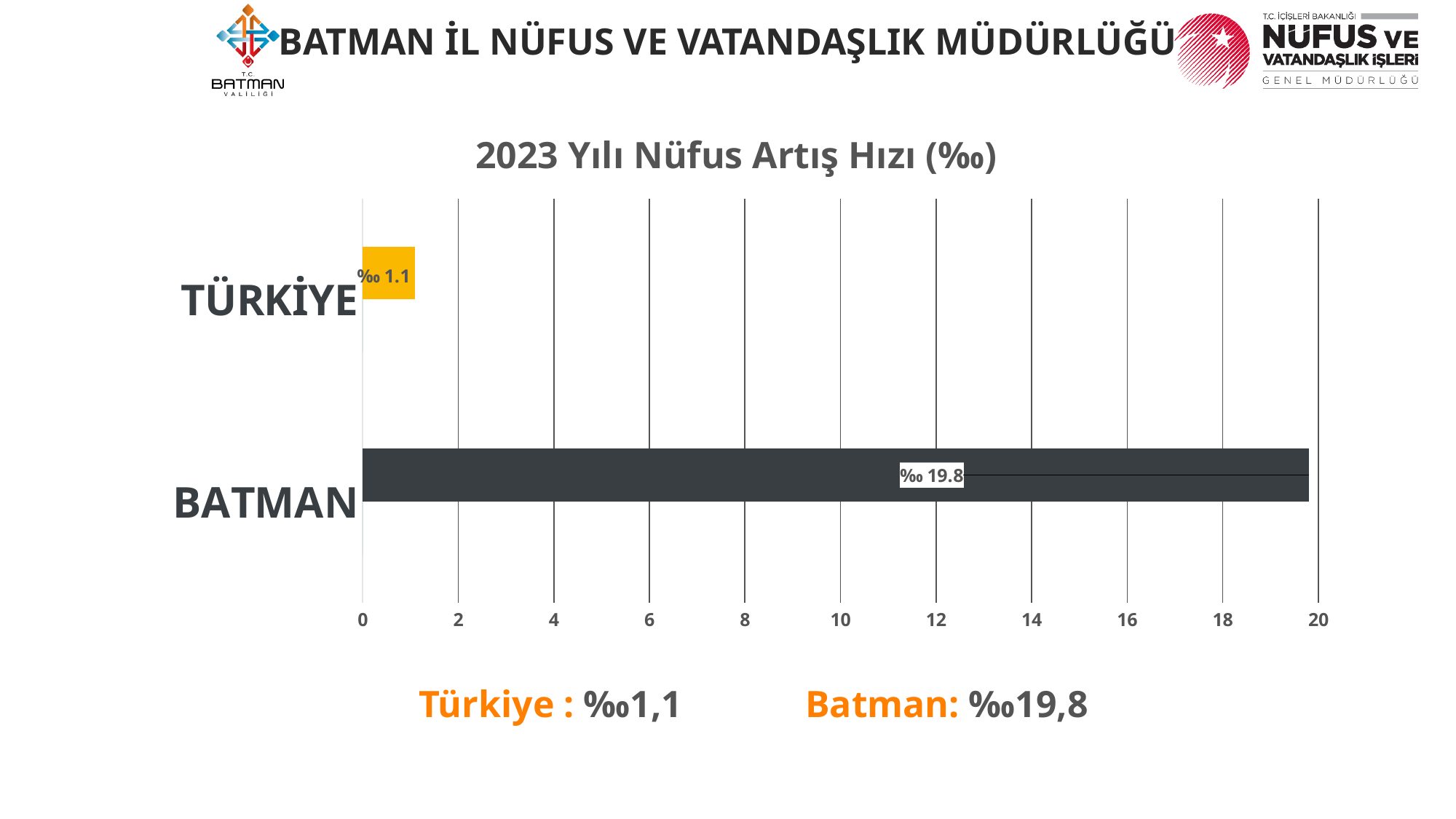
Which category has the highest population growth rate? BATMAN What is the population growth rate shown for BATMAN? ‰ 19.8 What is the population growth rate shown for TÜRKİYE? ‰ 1.1 What kind of chart is shown on the slide? bar chart What colour is the bar for TÜRKİYE? yellow Is the value for TÜRKİYE greater or less than 2? less Is the value for BATMAN greater or less than 18? greater What is the title of the chart? 2023 Yılı Nüfus Artış Hızı (‰) How many categories are shown in the chart? 2 Which category has the lowest population growth rate? TÜRKİYE What is the difference between the growth rates of BATMAN and TÜRKİYE? 18.7 Which has a larger population growth rate, TÜRKİYE or BATMAN? BATMAN